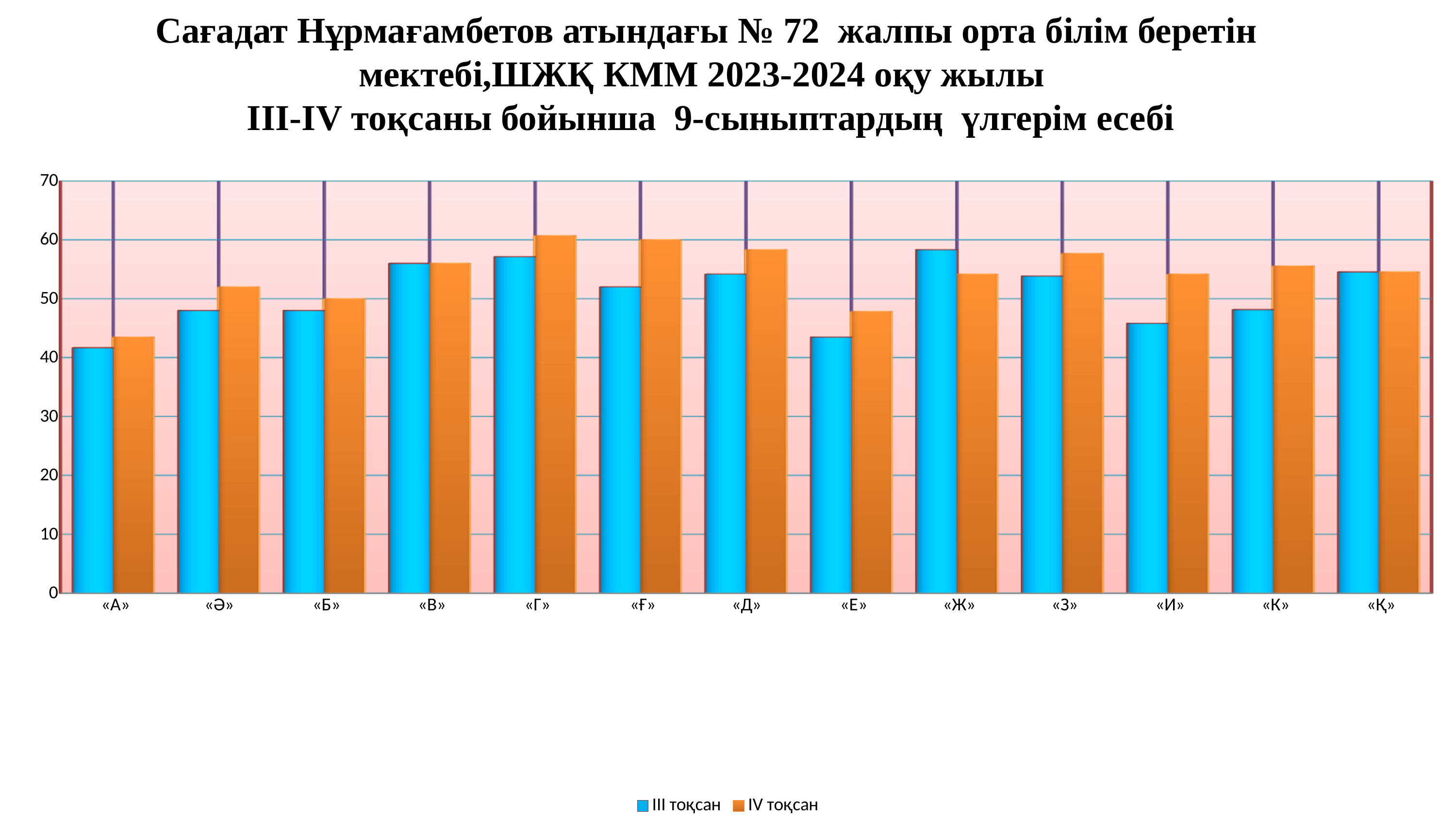
For category «Ғ», which is larger: III тоқсан or IV тоқсан? IV тоқсан Is the IV тоқсан value for «Д» greater or less than 50? greater For category «Ж», which is larger: III тоқсан or IV тоқсан? III тоқсан Which category has the lowest value for IV тоқсан? «А» How many categories (classes) are shown on the x axis? 13 Which colour represents the III тоқсан series? blue How many series does the legend list? 2 Is the III тоқсан value for «Е» greater or less than 50? less Is the III тоқсан value for «А» greater or less than 50? less What are the two series named in the legend? III тоқсан and IV тоқсан What kind of chart is shown on the slide? bar chart For category «И», which is larger: III тоқсан or IV тоқсан? IV тоқсан